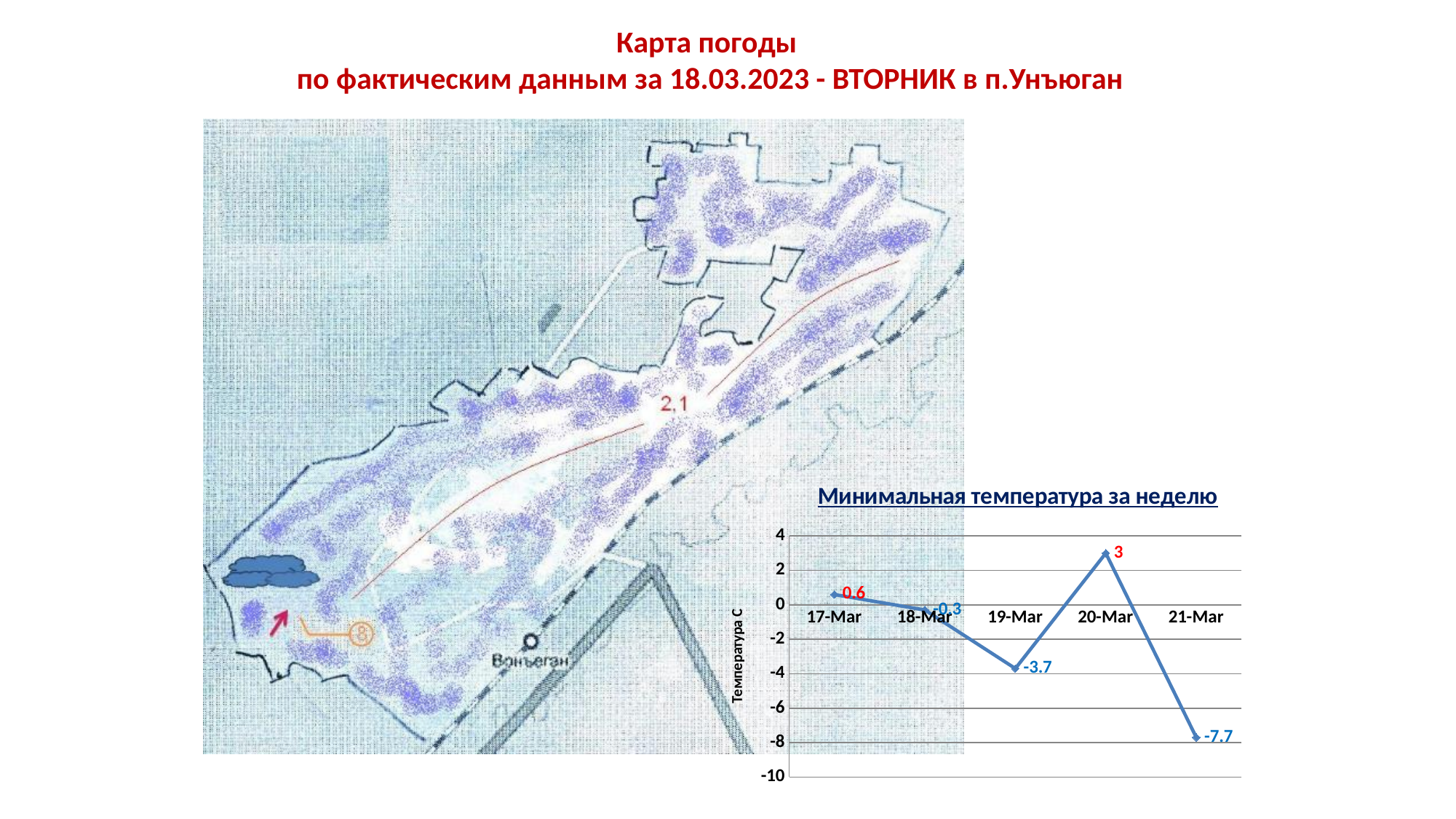
What is the difference between the values for 20-Mar and 21-Mar? 10.7 How many dates are plotted on the chart? 5 What is the minimum temperature value for 18-Mar? -0.3 What is the title of the chart? Минимальная температура за неделю What is the minimum temperature value for 19-Mar? -3.7 What is the minimum temperature value for 17-Mar? 0.6 Which date has the lowest minimum temperature? 21-Mar What type of chart is shown on the slide? line chart What is the minimum temperature value for 20-Mar? 3 Which is larger, the value for 17-Mar or the value for 19-Mar? 17-Mar Which date has the highest minimum temperature? 20-Mar What is the minimum temperature value for 21-Mar? -7.7